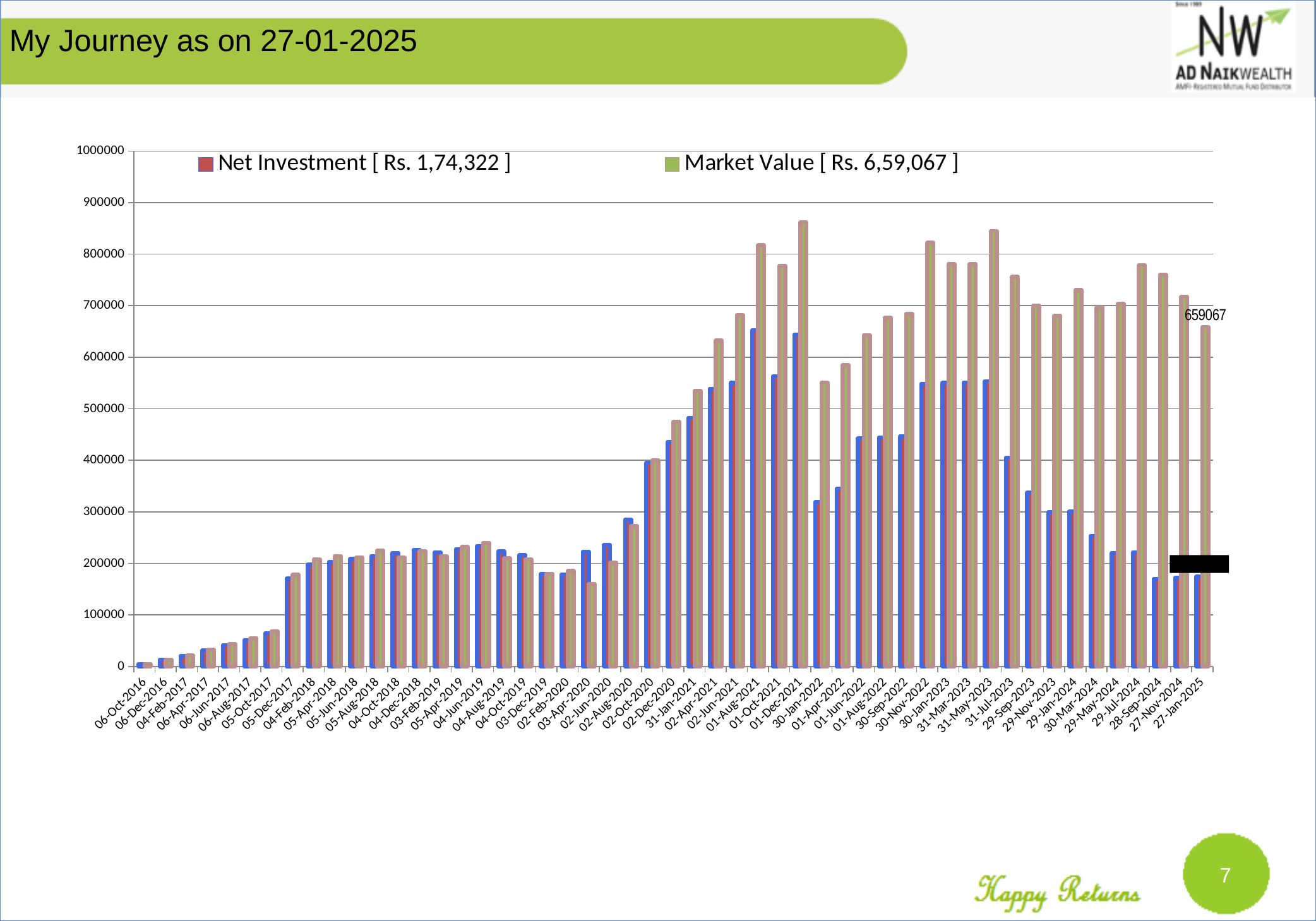
On 03-Apr-2020, which is larger: Net Investment or Market Value? Net Investment What are the two legend entries of the chart? Net Investment [ Rs. 1,74,322 ] and Market Value [ Rs. 6,59,067 ] What kind of chart is shown on the slide? Bar chart Does the Market Value rise or fall from 02-Oct-2020 to 01-Dec-2021? Rise On 27-Jan-2025, which is larger: Net Investment or Market Value? Market Value Is the Net Investment on 27-Jan-2025 greater or less than 200000? less Is the Market Value on 01-Dec-2021 greater or less than 800000? greater On which date is the Market Value bar the highest? 01-Dec-2021 What is the Market Value on 27-Jan-2025? 659067 On which date is the Market Value bar the lowest? 06-Oct-2016 Is the Net Investment on 01-Aug-2021 greater or less than 600000? greater How many series does the chart's legend list? 2